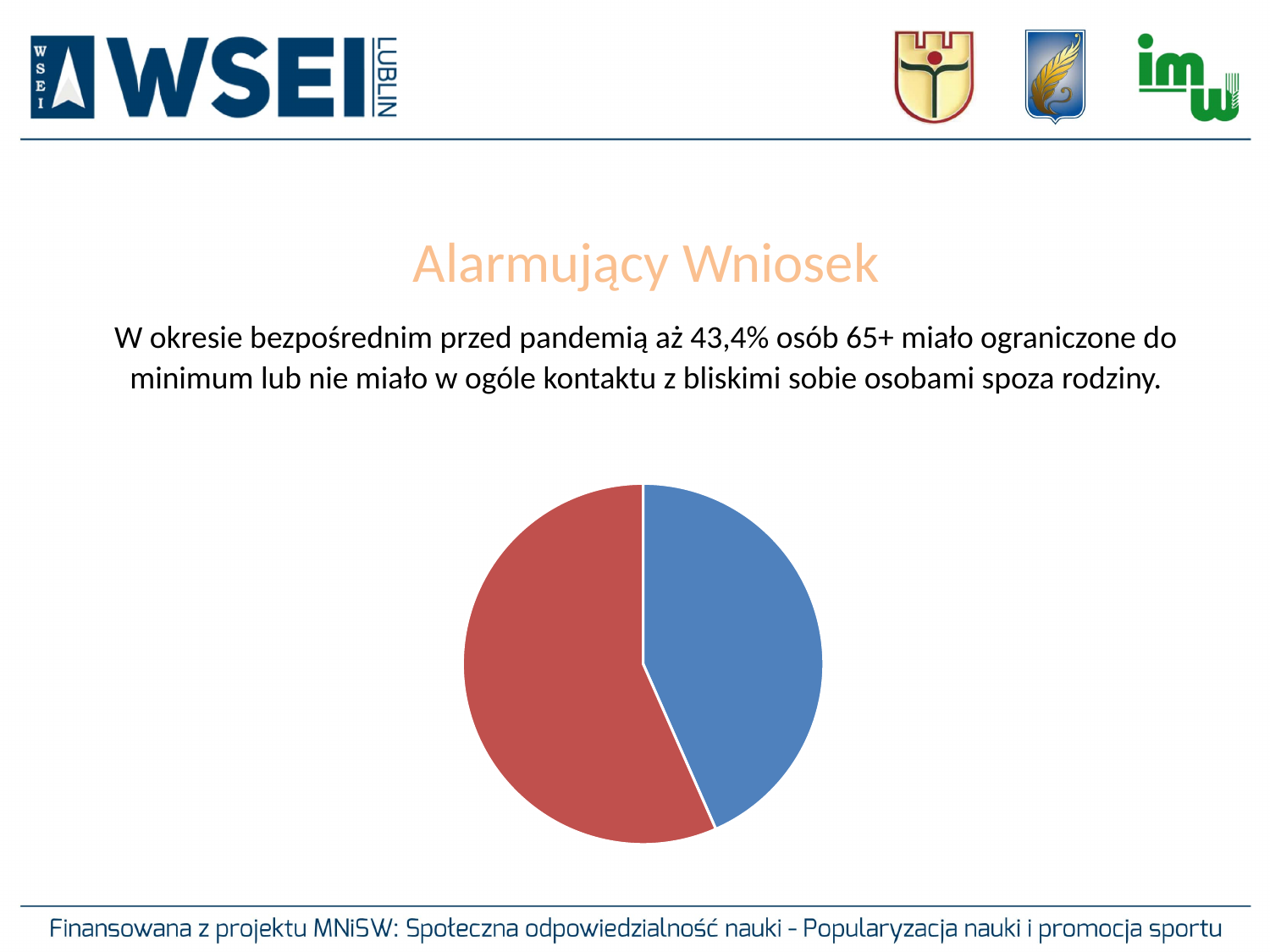
How many slices does the pie chart have? 2 Which slice of the pie chart is larger, the red one or the blue one? the red one Does the red slice of the pie chart cover more or less than half of the pie? more Which slice of the pie chart is the largest? the red one Does the blue slice of the pie chart cover more or less than half of the pie? less Which slice of the pie chart is the smallest? the blue one What kind of chart is shown on the slide? pie chart Does the pie chart display a legend? No What two colours are used for the slices of the pie chart? blue and red